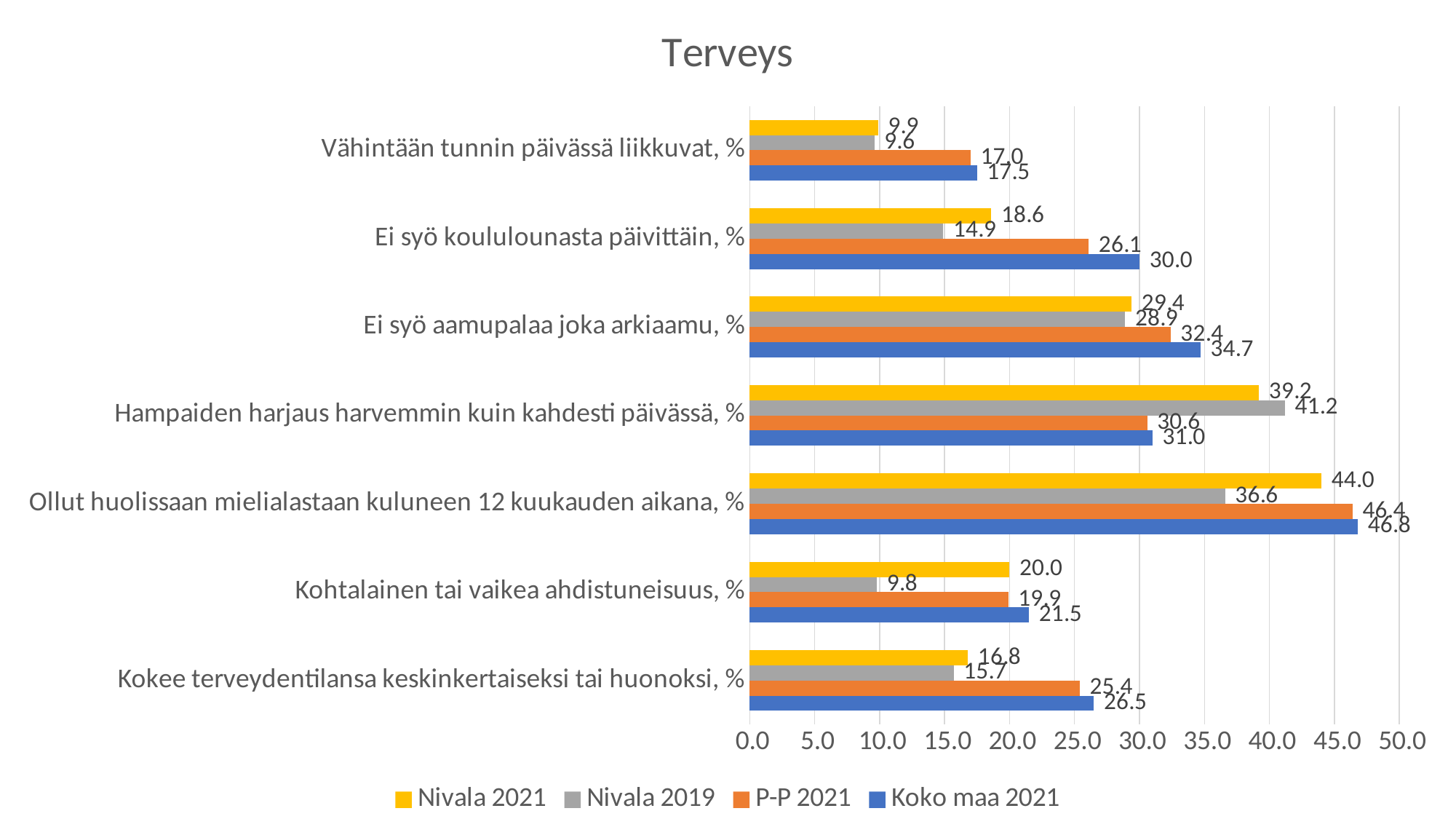
How many series does the legend list? 4 What is the title of the chart? Terveys Which category has the highest Koko maa 2021 value? Ollut huolissaan mielialastaan kuluneen 12 kuukauden aikana, % What is the difference between the P-P 2021 and Nivala 2021 values for 'Kokee terveydentilansa keskinkertaiseksi tai huonoksi, %'? 8.6 What is the Koko maa 2021 value for 'Ei syö koululounasta päivittäin, %'? 30.0 What is the Nivala 2019 value for 'Hampaiden harjaus harvemmin kuin kahdesti päivässä, %'? 41.2 For 'Kohtalainen tai vaikea ahdistuneisuus, %', which is larger: the Nivala 2021 value or the Nivala 2019 value? Nivala 2021 Is the Nivala 2021 value for 'Ollut huolissaan mielialastaan kuluneen 12 kuukauden aikana, %' greater or less than 40.0? greater Which category has the lowest Nivala 2019 value? Vähintään tunnin päivässä liikkuvat, % How many categories are shown on the chart? 7 What is the Nivala 2021 value for 'Kohtalainen tai vaikea ahdistuneisuus, %'? 20.0 What type of chart is shown on the slide? Bar chart